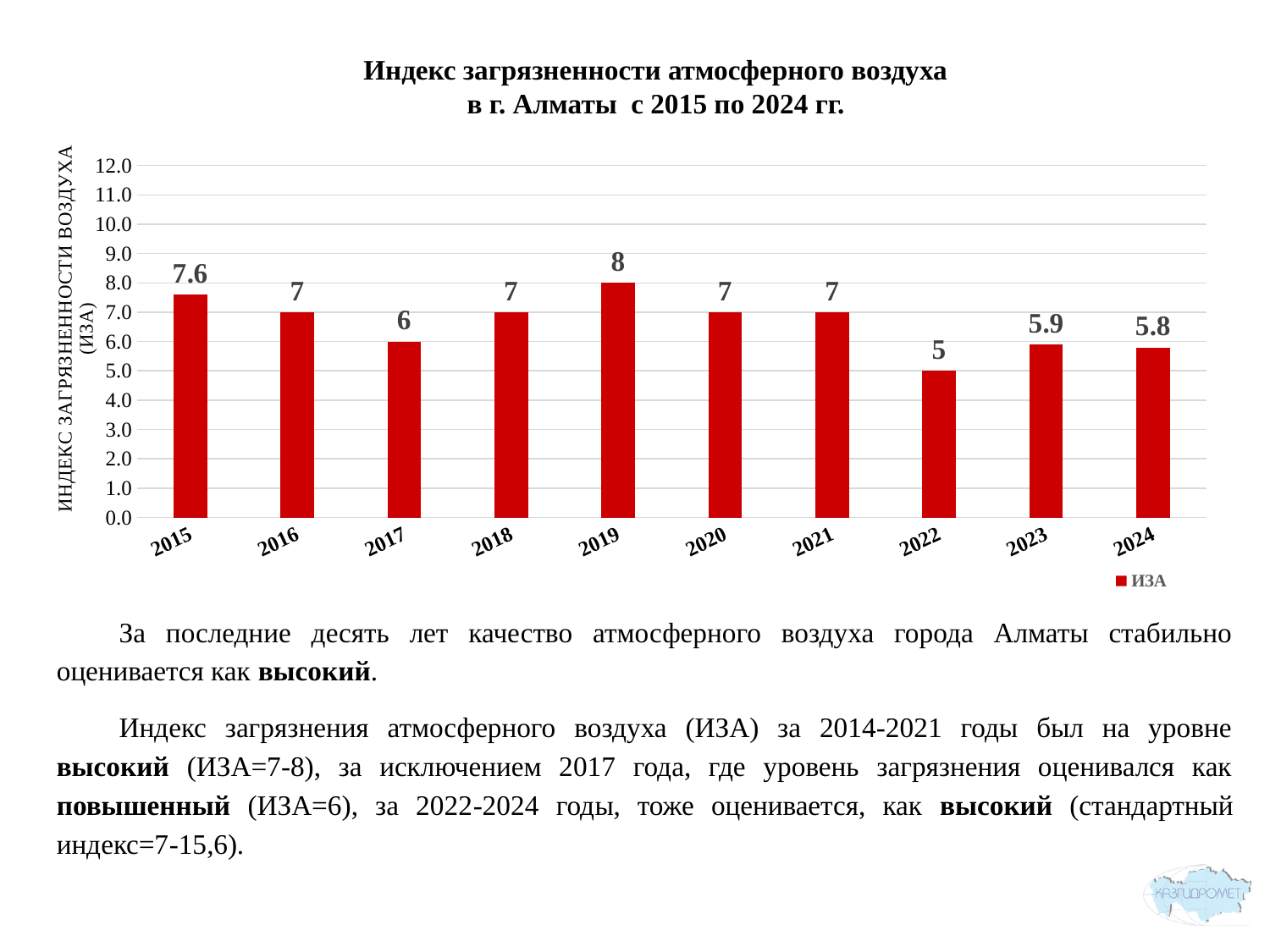
What is the legend entry for the series? ИЗА What is the value for 2024? 5.8 Which year has the lowest value? 2022 Is the value for 2022 greater or less than 6.0? less What is the value for 2015? 7.6 How many series does the legend list? 1 Which is larger, the value for 2017 or the value for 2023? 2017 What kind of chart is shown? bar chart What is the difference between the values for 2015 and 2024? 1.8 What is the value for 2019? 8 Which year has the highest value? 2019 How many years are shown on the x axis? 10